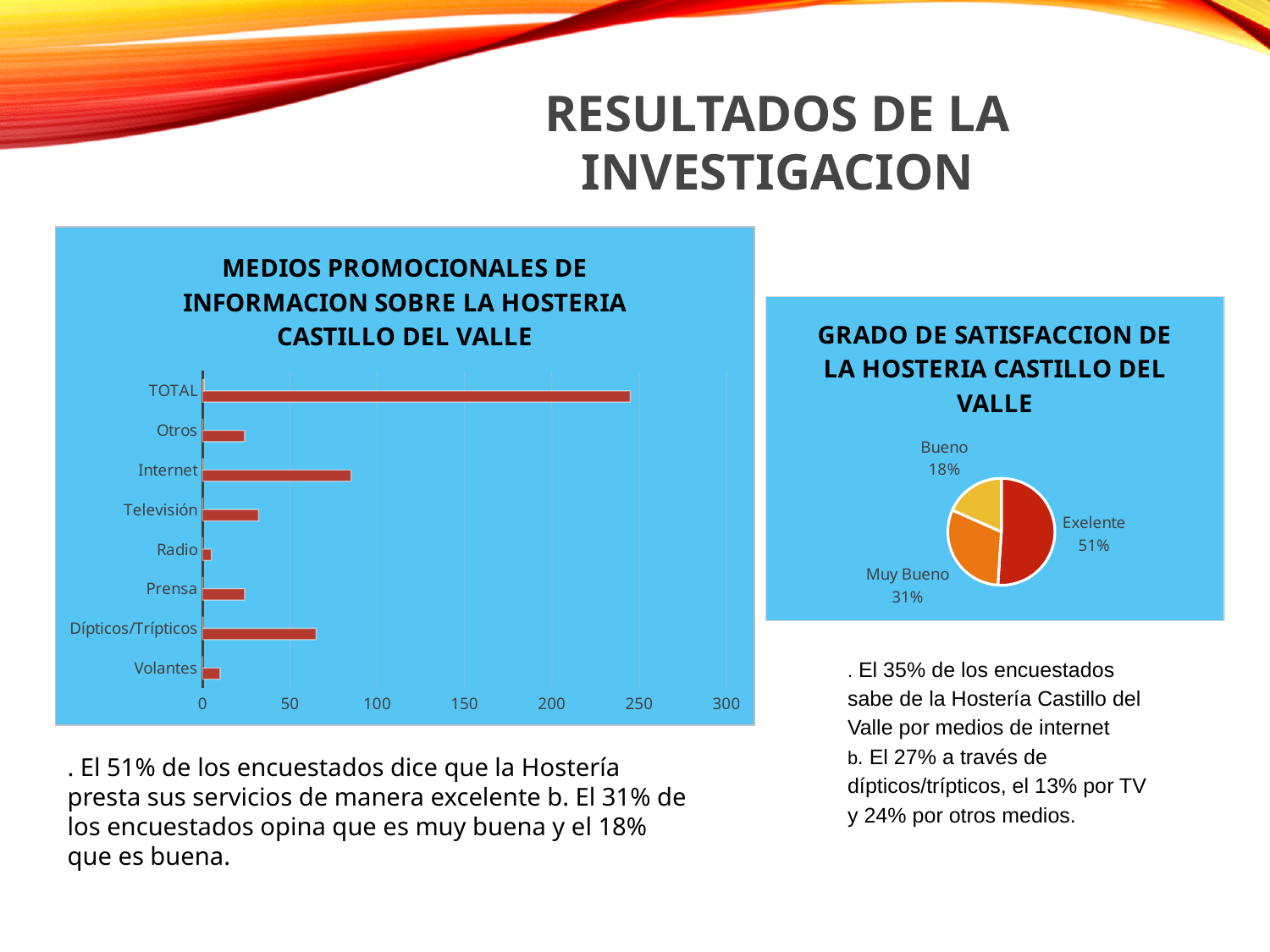
In the chart 'MEDIOS PROMOCIONALES DE INFORMACION SOBRE LA HOSTERIA CASTILLO DEL VALLE', which is larger, Internet or Televisión? Internet In the pie chart 'GRADO DE SATISFACCION DE LA HOSTERIA CASTILLO DEL VALLE', how many percentage points larger is Exelente than Muy Bueno? 20 What kind of chart is the chart titled 'MEDIOS PROMOCIONALES DE INFORMACION SOBRE LA HOSTERIA CASTILLO DEL VALLE'? bar chart In the chart 'MEDIOS PROMOCIONALES DE INFORMACION SOBRE LA HOSTERIA CASTILLO DEL VALLE', which category has the longest bar? TOTAL In the chart 'MEDIOS PROMOCIONALES DE INFORMACION SOBRE LA HOSTERIA CASTILLO DEL VALLE', is the value for Internet greater or less than 50? greater In the pie chart 'GRADO DE SATISFACCION DE LA HOSTERIA CASTILLO DEL VALLE', what share is labelled Exelente? 51% In the pie chart 'GRADO DE SATISFACCION DE LA HOSTERIA CASTILLO DEL VALLE', what share is labelled Bueno? 18% In the chart 'MEDIOS PROMOCIONALES DE INFORMACION SOBRE LA HOSTERIA CASTILLO DEL VALLE', which category has the shortest bar? Radio In the chart 'MEDIOS PROMOCIONALES DE INFORMACION SOBRE LA HOSTERIA CASTILLO DEL VALLE', is the value for Dípticos/Trípticos greater or less than 100? less In the chart 'MEDIOS PROMOCIONALES DE INFORMACION SOBRE LA HOSTERIA CASTILLO DEL VALLE', is the value for TOTAL greater or less than 200? greater In the pie chart 'GRADO DE SATISFACCION DE LA HOSTERIA CASTILLO DEL VALLE', how many slices are there? 3 In the chart 'MEDIOS PROMOCIONALES DE INFORMACION SOBRE LA HOSTERIA CASTILLO DEL VALLE', how many categories are shown on the vertical axis? 8